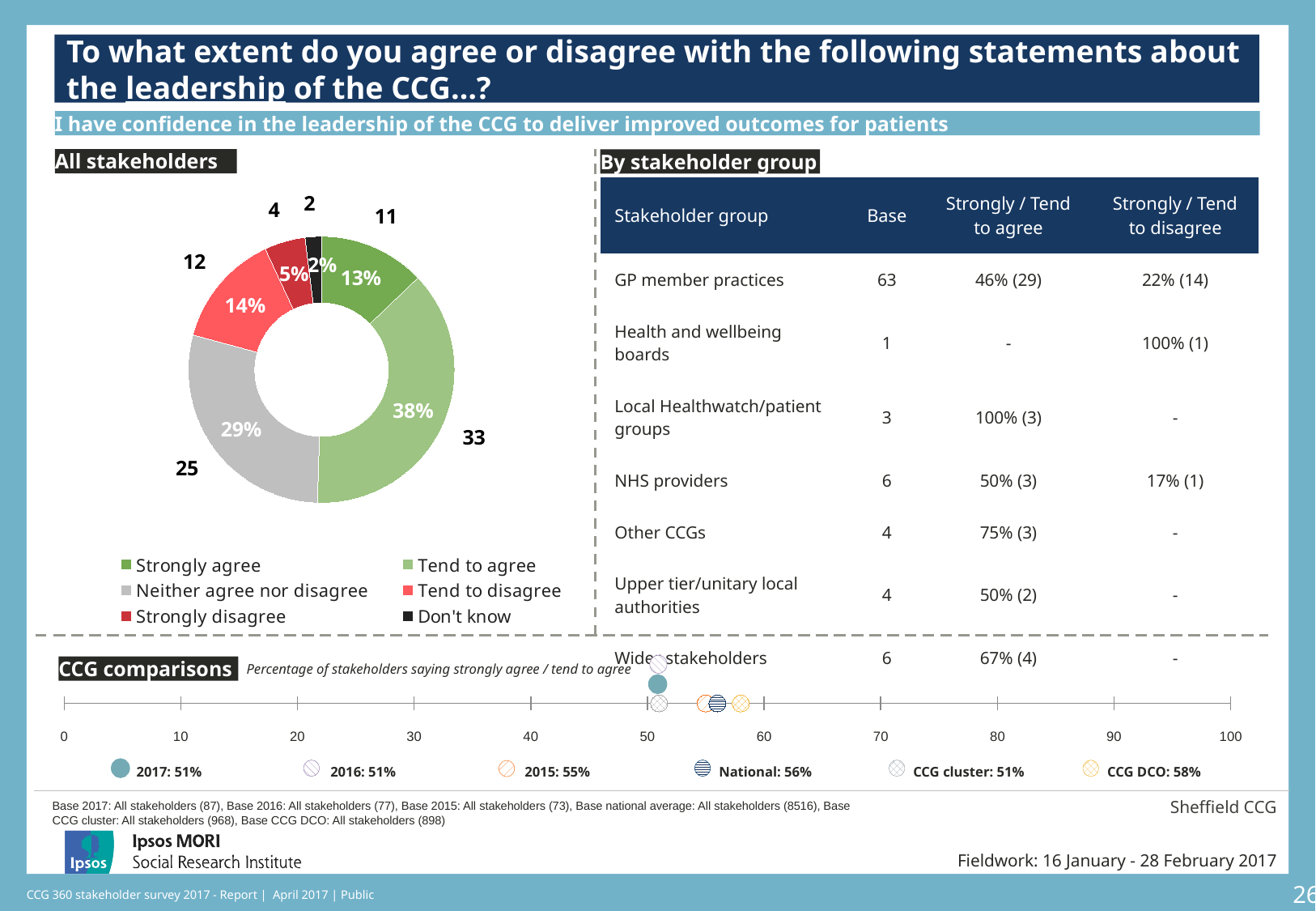
In the 'All stakeholders' donut chart, which response category has the smallest share? Don't know In the 'All stakeholders' donut chart, which is larger: the share for 'Tend to disagree' or the share for 'Strongly agree'? Tend to disagree What type of chart is used for the 'All stakeholders' section? Donut chart How many response categories does the legend of the 'All stakeholders' donut chart list? 6 In the 'All stakeholders' donut chart, what percentage of stakeholders said 'Neither agree nor disagree'? 29% In the 'CCG comparisons' chart, what percentage of stakeholders said strongly agree / tend to agree in 2017? 51% In the 'CCG comparisons' chart, which comparator has the highest percentage? CCG DCO: 58% In the 'All stakeholders' donut chart, what percentage of stakeholders said 'Tend to agree'? 38% In the 'CCG comparisons' chart, what is the difference in percentage points between the National figure and the 2017 figure? 5 In the 'All stakeholders' donut chart, what is the difference in percentage points between 'Tend to agree' and 'Strongly agree'? 25 In the 'All stakeholders' donut chart, what percentage of stakeholders said 'Strongly disagree'? 5% In the 'All stakeholders' donut chart, which response category has the largest share? Tend to agree